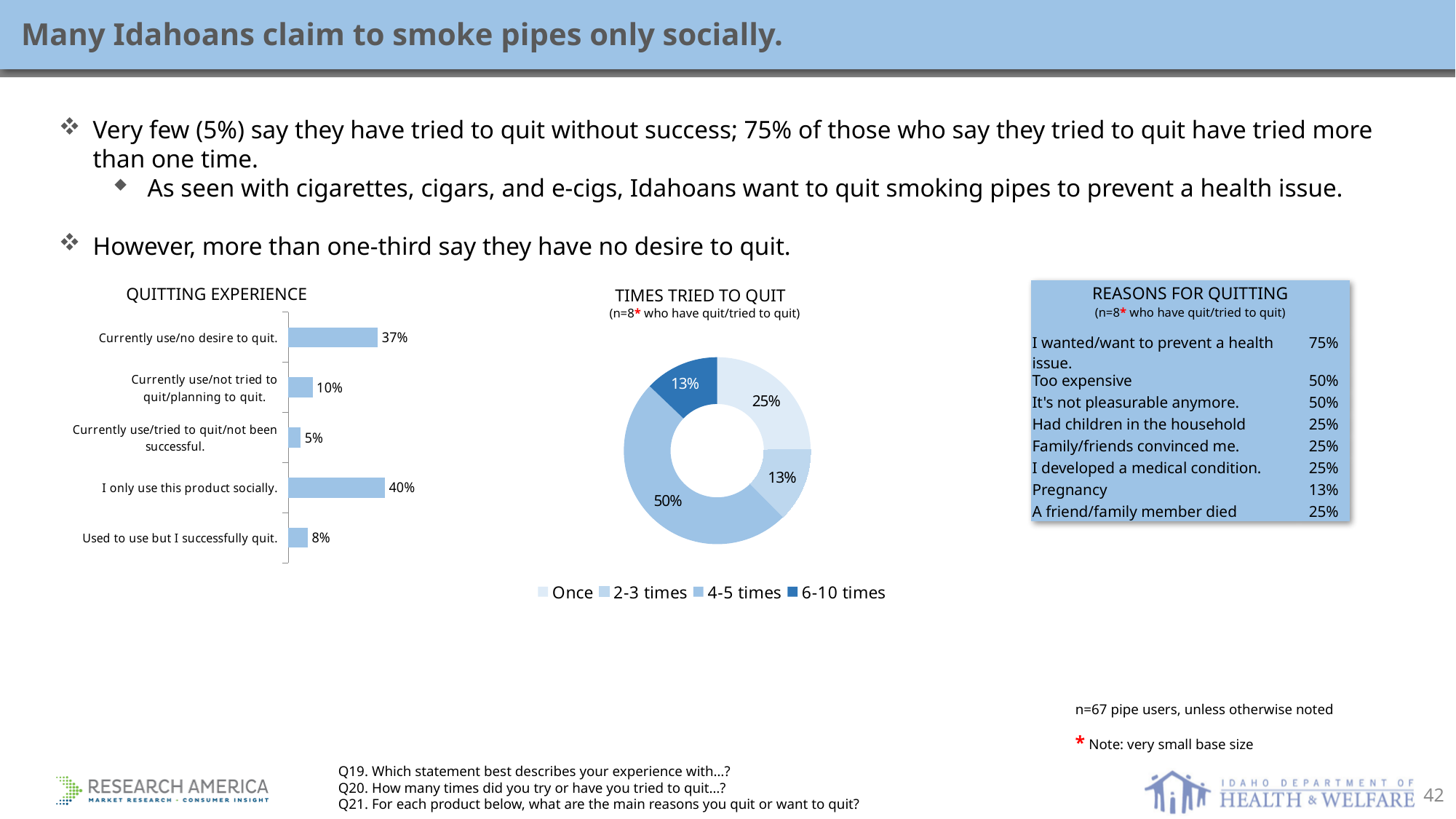
In the QUITTING EXPERIENCE chart, what percentage currently use and have no desire to quit? 37% In the TIMES TRIED TO QUIT chart, which is larger: the share for 'Once' or the share for '6-10 times'? Once In the QUITTING EXPERIENCE chart, what percentage say they only use this product socially? 40% In the TIMES TRIED TO QUIT chart, what share of respondents tried to quit 4-5 times? 50% In the TIMES TRIED TO QUIT chart, what share of respondents tried to quit once? 25% In the QUITTING EXPERIENCE chart, what is the difference between 'I only use this product socially' and 'Currently use/no desire to quit'? 3% In the QUITTING EXPERIENCE chart, which category has the highest value? I only use this product socially. In the QUITTING EXPERIENCE chart, how many categories are shown? 5 In the TIMES TRIED TO QUIT chart, how many categories does the legend list? 4 What type of chart is the QUITTING EXPERIENCE chart? Bar chart In the QUITTING EXPERIENCE chart, what is the value for 'Used to use but I successfully quit'? 8% In the QUITTING EXPERIENCE chart, which category has the lowest value? Currently use/tried to quit/not been successful.